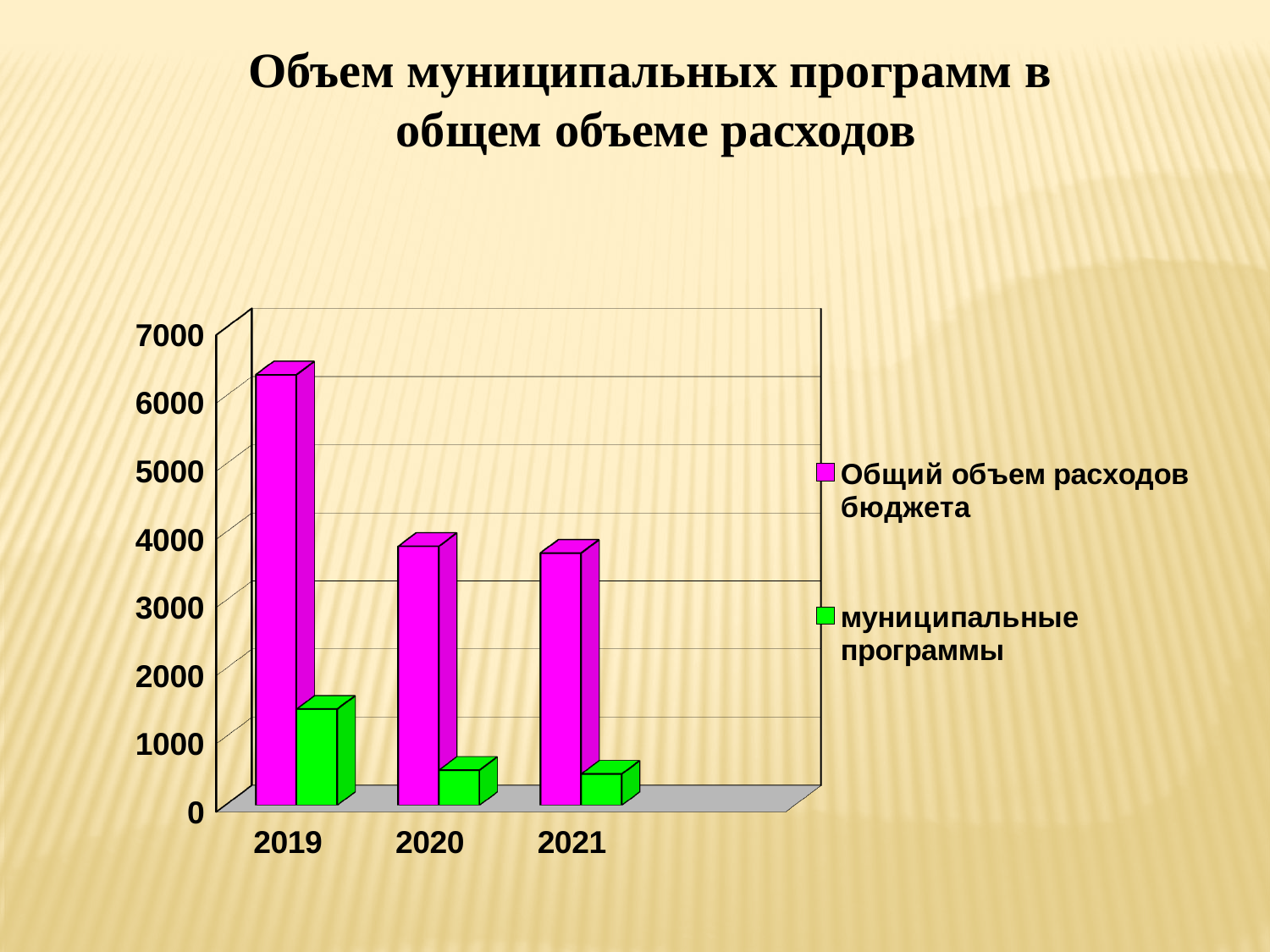
Is the value for муниципальные программы in 2019 greater or less than 1000? greater Does the value for Общий объем расходов бюджета rise or fall from 2019 to 2021? fall What kind of chart is shown on the slide? bar chart Is the value for Общий объем расходов бюджета in 2020 greater or less than 4000? less What colour are the bars for муниципальные программы? green Is the value for Общий объем расходов бюджета in 2019 greater or less than 6000? greater Which year has the highest value for Общий объем расходов бюджета? 2019 How many years are shown on the x axis of the chart? 3 Which is larger: Общий объем расходов бюджета in 2019 or in 2020? 2019 How many series does the chart legend list? 2 Which year has the highest value for муниципальные программы? 2019